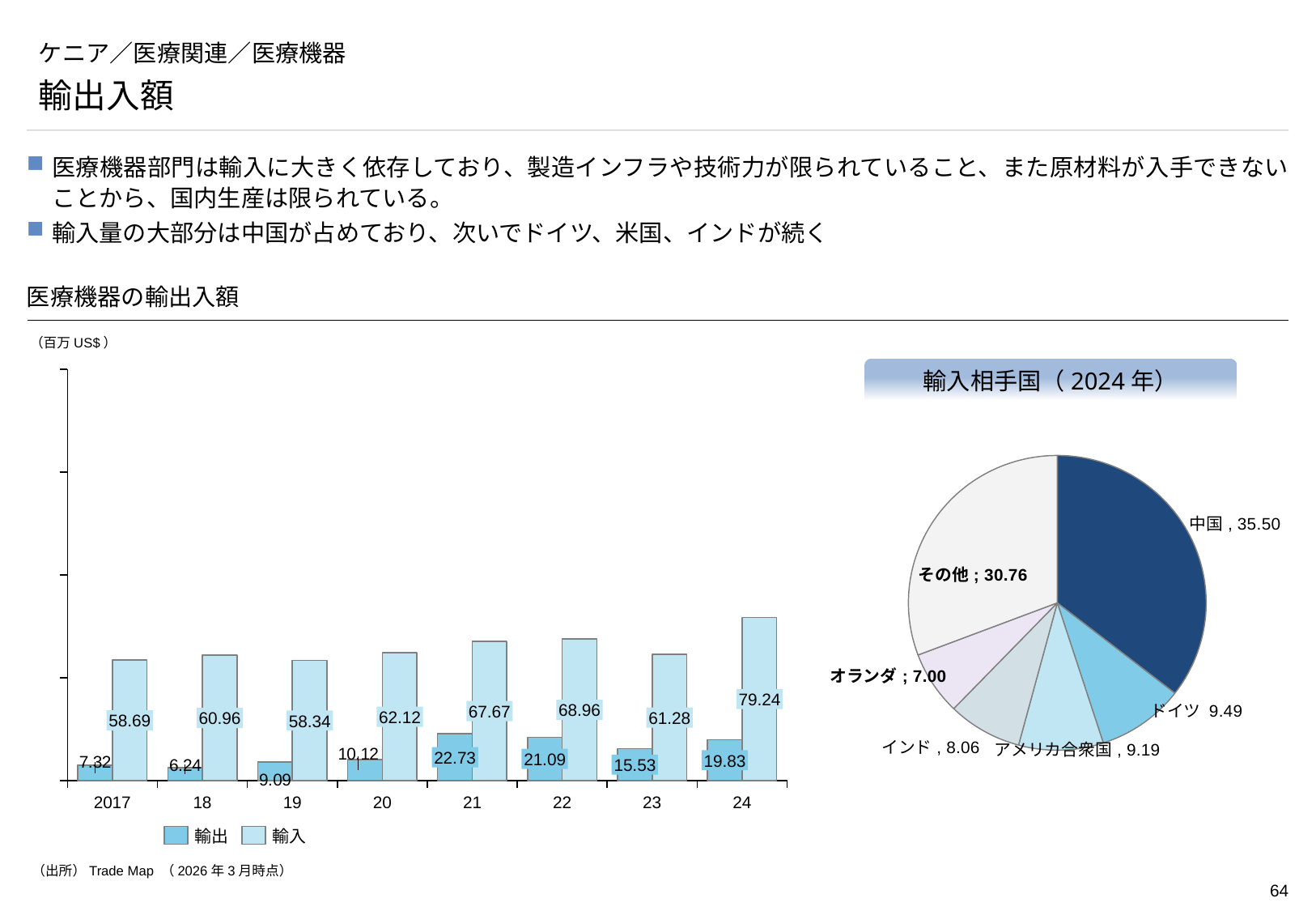
In the bar chart 医療機器の輸出入額, how many series does the legend list? 2 What kind of chart is 輸入相手国（2024年）? pie chart In the pie chart 輸入相手国（2024年）, which named country has the smallest value? オランダ In the bar chart 医療機器の輸出入額, what is the 輸出 value for 2017? 7.32 In the bar chart 医療機器の輸出入額, is the 輸出 value for 22 larger or smaller than the 輸出 value for 23? larger In the bar chart 医療機器の輸出入額, how many years are shown on the x axis? 8 In the bar chart 医療機器の輸出入額, which year has the lowest 輸入 value? 19 In the bar chart 医療機器の輸出入額, what is the 輸入 value for 24? 79.24 In the bar chart 医療機器の輸出入額, what is the difference between the 輸入 and 輸出 values for 24? 59.41 In the pie chart 輸入相手国（2024年）, what is the value for 中国? 35.50 In the pie chart 輸入相手国（2024年）, what is the difference between ドイツ and アメリカ合衆国? 0.30 In the bar chart 医療機器の輸出入額, which year has the highest 輸出 value? 21